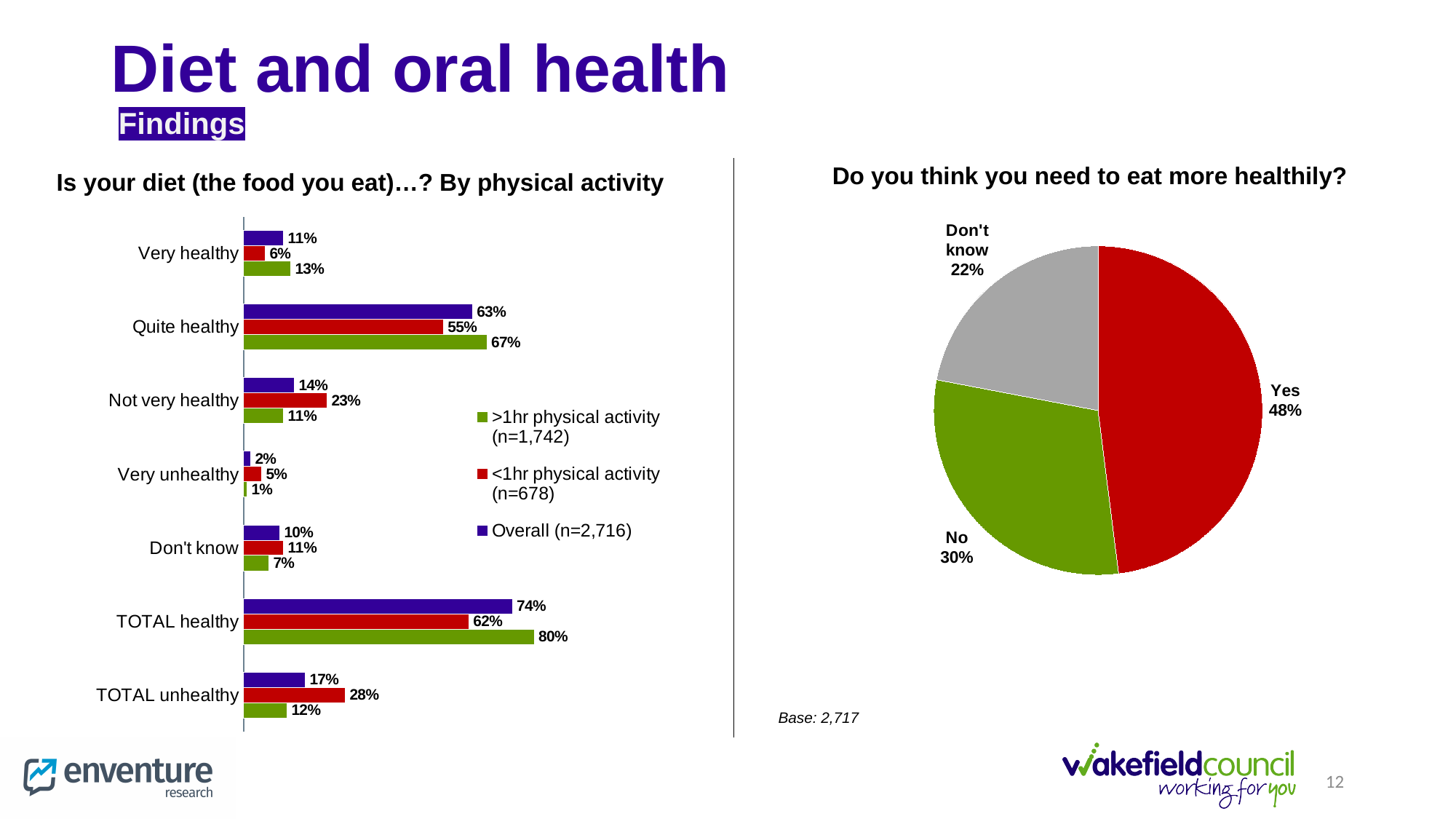
In the bar chart 'Is your diet (the food you eat)…? By physical activity', what is the Overall value for Quite healthy? 63% In the bar chart 'Is your diet (the food you eat)…? By physical activity', which group has the larger value for Very healthy: >1hr physical activity or <1hr physical activity? >1hr physical activity How many categories are shown on the bar chart 'Is your diet (the food you eat)…? By physical activity'? 7 What kind of chart is 'Do you think you need to eat more healthily?'? Pie chart In the bar chart 'Is your diet (the food you eat)…? By physical activity', what is the difference between the TOTAL unhealthy values for <1hr physical activity and >1hr physical activity? 16% In the bar chart 'Is your diet (the food you eat)…? By physical activity', which category has the highest Overall value? TOTAL healthy In the pie chart 'Do you think you need to eat more healthily?', which answer has the smallest slice? Don't know How many series does the legend of the bar chart 'Is your diet (the food you eat)…? By physical activity' list? 3 In the pie chart 'Do you think you need to eat more healthily?', what share of respondents answered Yes? 48% In the bar chart 'Is your diet (the food you eat)…? By physical activity', what is the value for TOTAL healthy among those with >1hr physical activity? 80% In the bar chart 'Is your diet (the food you eat)…? By physical activity', which category has the lowest value for >1hr physical activity? Very unhealthy In the bar chart 'Is your diet (the food you eat)…? By physical activity', what is the value for Not very healthy among those with <1hr physical activity? 23%